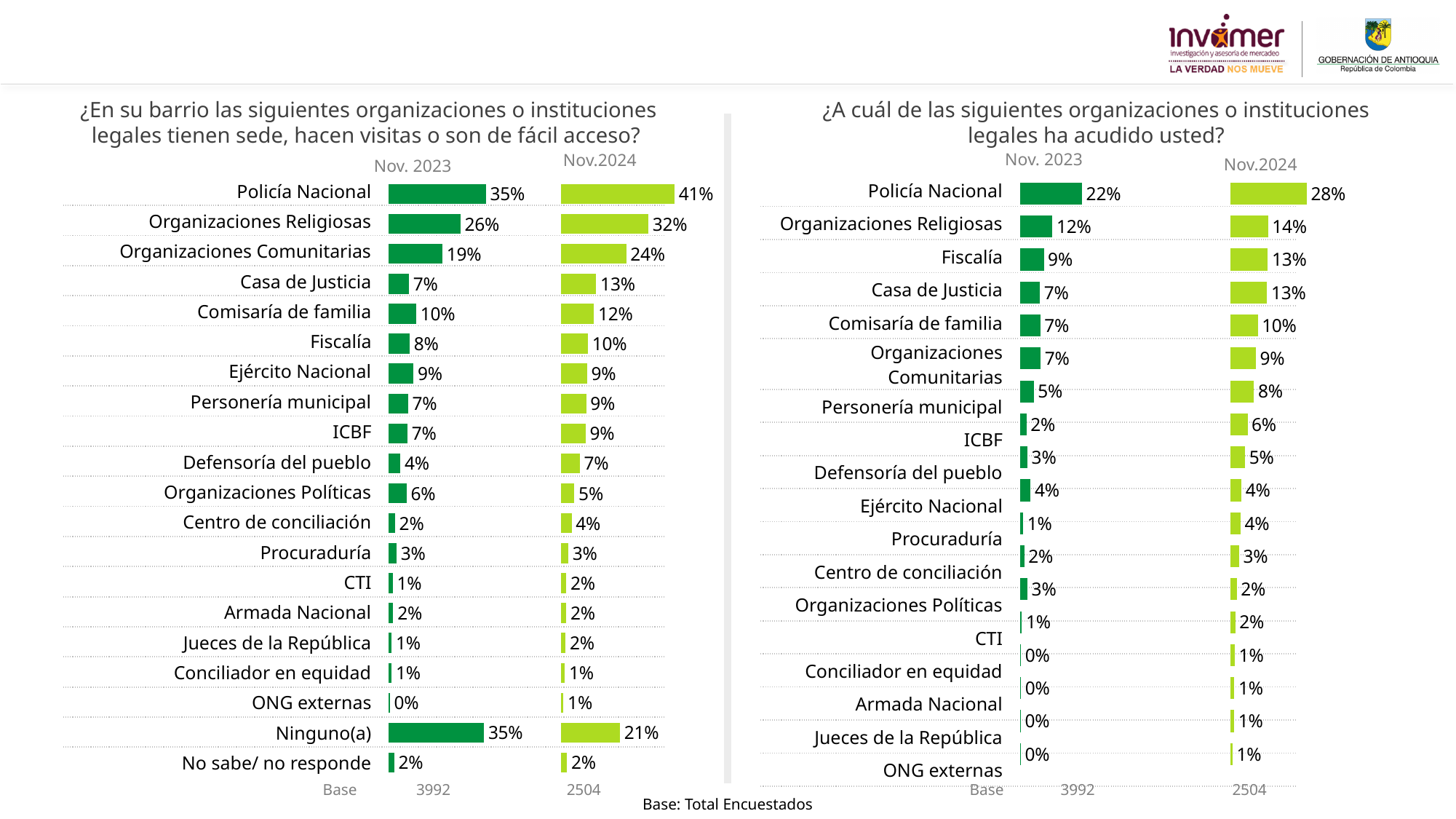
In the left chart (¿En su barrio...?), what is the difference between the Nov.2024 and Nov. 2023 values for Organizaciones Religiosas? 6 percentage points In the left chart (¿En su barrio...?), which category has the lowest Nov. 2023 value? ONG externas In the left chart (¿En su barrio...?), which is larger for Casa de Justicia: the Nov. 2023 value or the Nov.2024 value? Nov.2024 In the left chart (¿En su barrio...?), how many categories are listed? 20 In the right chart (¿A cuál... ha acudido usted?), what is the difference between the Nov.2024 and Nov. 2023 values for Policía Nacional? 6 percentage points In the left chart (¿En su barrio las siguientes organizaciones o instituciones legales tienen sede...?), what is the Nov.2024 value for Policía Nacional? 41% In the left chart (¿En su barrio...?), what is the Nov.2024 value for Ninguno(a)? 21% What type of chart is used on this slide? Bar chart In the left chart (¿En su barrio...?), which category has the highest Nov.2024 value? Policía Nacional In the right chart (¿A cuál de las siguientes organizaciones o instituciones legales ha acudido usted?), what is the Nov.2024 value for Policía Nacional? 28% In the left chart (¿En su barrio...?), what is the Nov. 2023 value for Organizaciones Comunitarias? 19% In the right chart (¿A cuál... ha acudido usted?), what is the Nov. 2023 value for Fiscalía? 9%